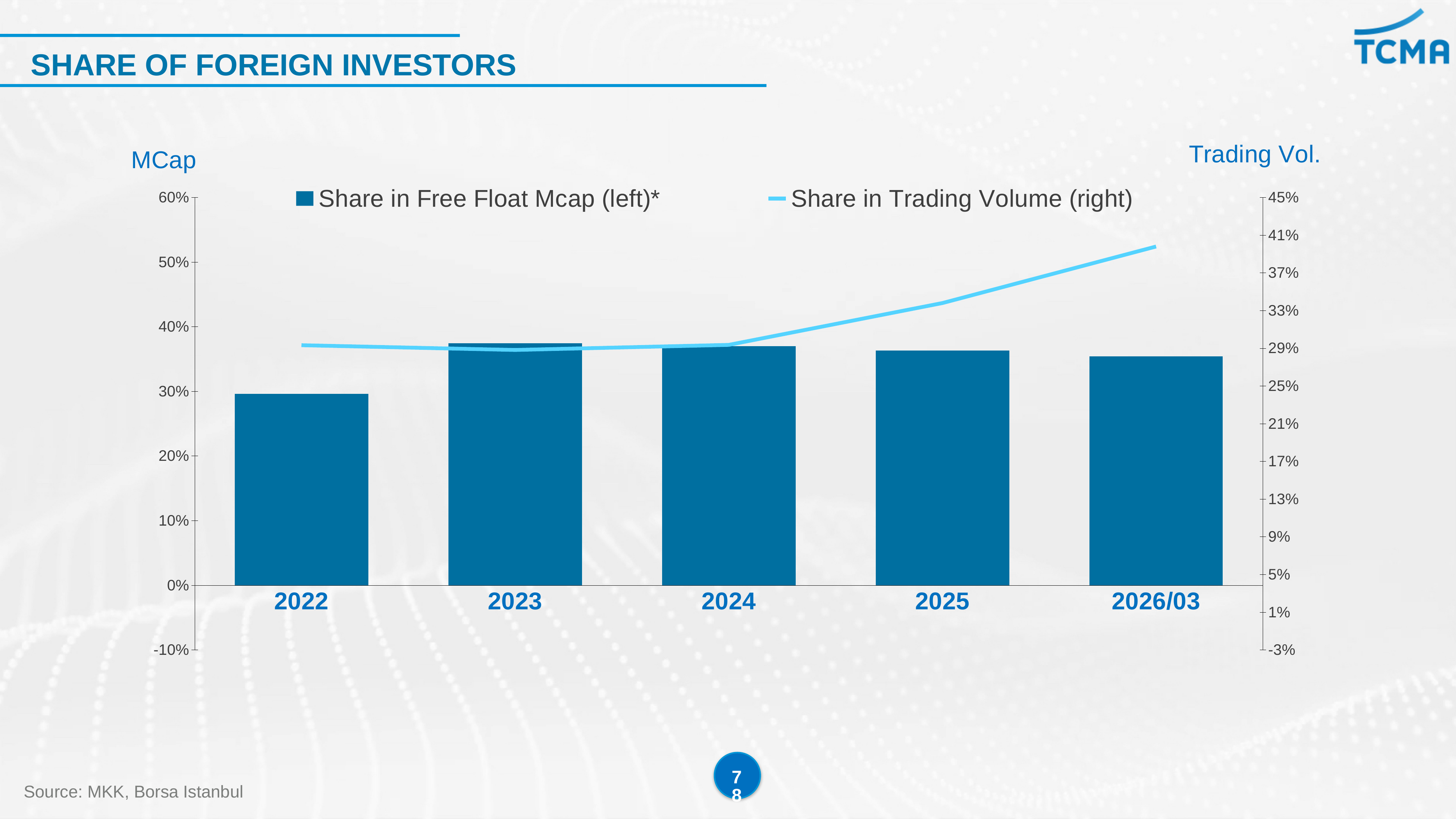
How many years or periods are shown on the x axis? 5 What is the title of the slide? SHARE OF FOREIGN INVESTORS How many series does the legend list? 2 What kind of chart is shown on the slide? A combined bar and line chart Is the Share in Trading Volume for 2022 greater or less than 33% on the right axis? less Does the Share in Trading Volume line rise or fall from 2024 to 2026/03? It rises Is the Share in Trading Volume for 2026/03 greater or less than 37% on the right axis? greater Which is larger, the Share in Free Float Mcap bar for 2022 or for 2025? 2025 Which period has the lowest Share in Free Float Mcap bar? 2022 Which period has the highest Share in Trading Volume value? 2026/03 Is the Share in Free Float Mcap for 2023 greater or less than 30%? greater